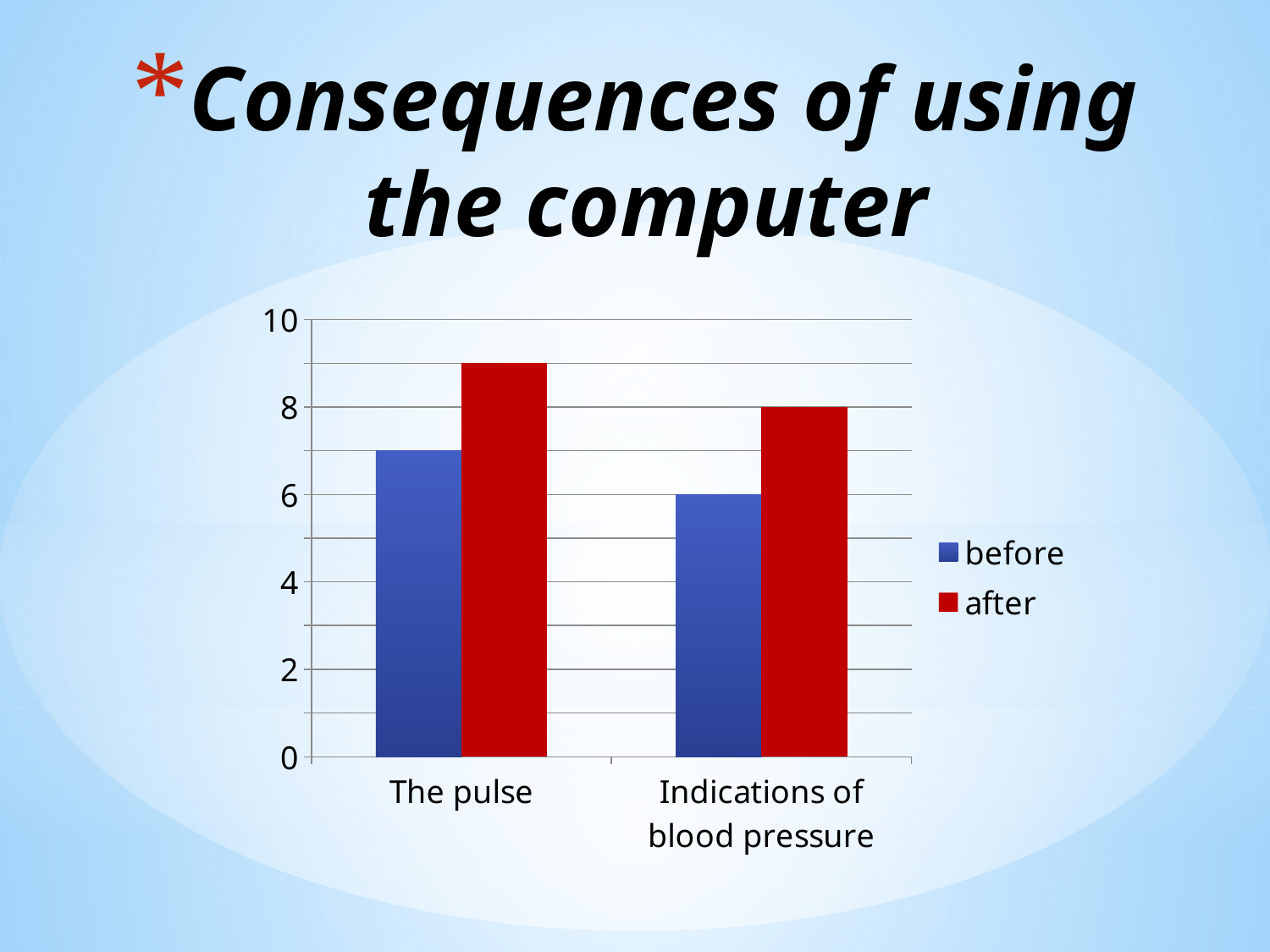
How many series does the legend list? 2 What kind of chart is shown on the slide? bar chart Is the 'before' value for 'The pulse' greater or less than 8? less What is the difference between the 'after' and 'before' values for 'Indications of blood pressure'? 2 How many categories are shown on the x axis? 2 For 'The pulse', which is larger: the 'before' value or the 'after' value? after Which category has the highest 'after' value? The pulse Which category has the lowest 'before' value? Indications of blood pressure Which colour represents the 'after' series in the legend? red What is the value for 'after' in the 'Indications of blood pressure' category? 8 Is the 'after' value for 'The pulse' greater or less than 8? greater What is the value for 'before' in the 'Indications of blood pressure' category? 6